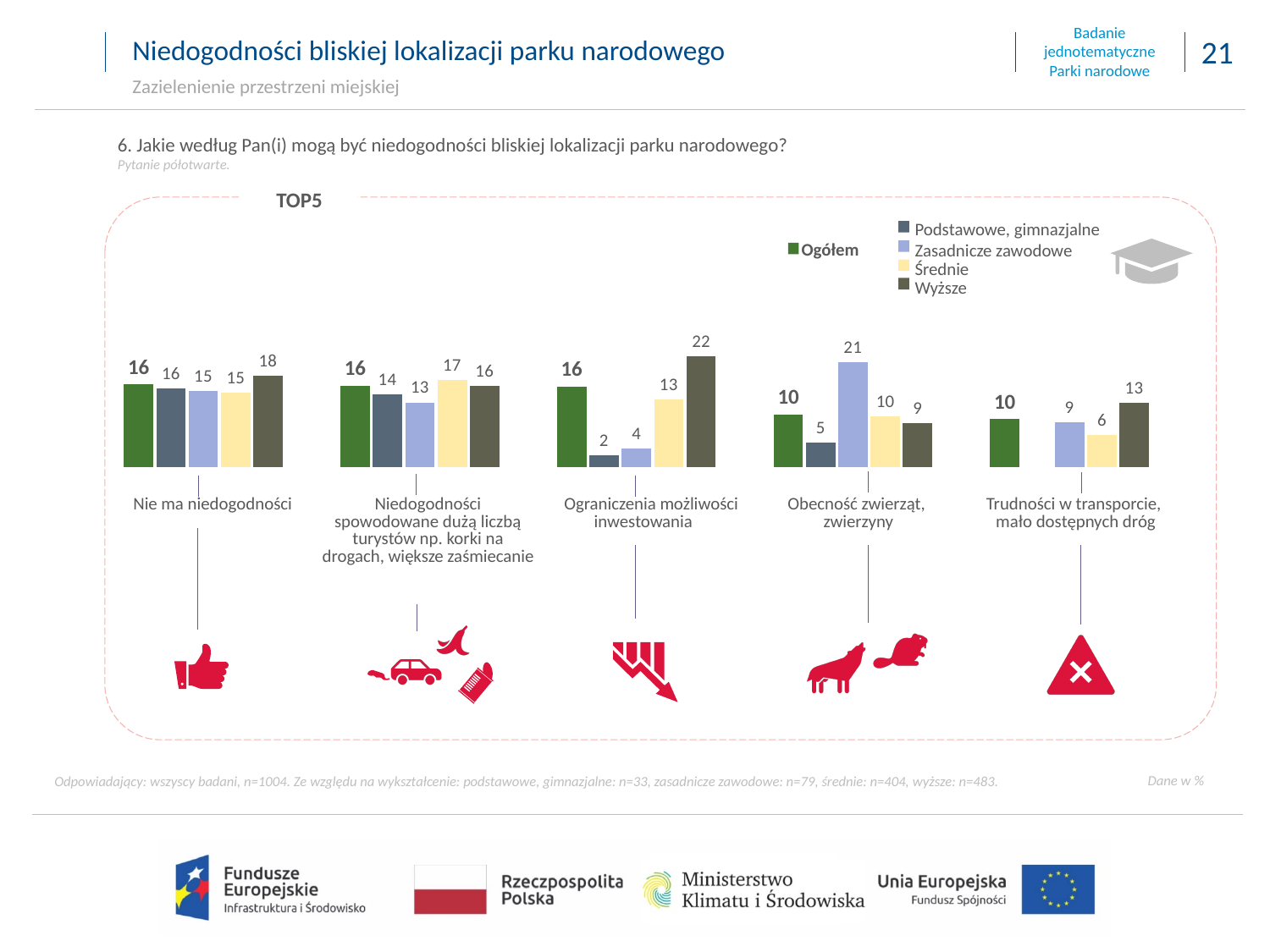
What is the Wyższe value for 'Ograniczenia możliwości inwestowania'? 22 What is the Ogółem value for 'Nie ma niedogodności'? 16 What is the Ogółem value for 'Ograniczenia możliwości inwestowania'? 16 What is the difference between the Wyższe and Podstawowe, gimnazjalne values for 'Ograniczenia możliwości inwestowania'? 20 For 'Obecność zwierząt, zwierzyny', which is larger: the Zasadnicze zawodowe value or the Wyższe value? Zasadnicze zawodowe How many categories (niedogodności) are shown on the chart? 5 What is the Zasadnicze zawodowe value for 'Obecność zwierząt, zwierzyny'? 21 What is the Średnie value for 'Trudności w transporcie, mało dostępnych dróg'? 6 Which education group has the lowest value for 'Ograniczenia możliwości inwestowania'? Podstawowe, gimnazjalne How many series does the chart legend list? 5 Which education group has the highest value for 'Ograniczenia możliwości inwestowania'? Wyższe What type of chart is shown on the slide? bar chart